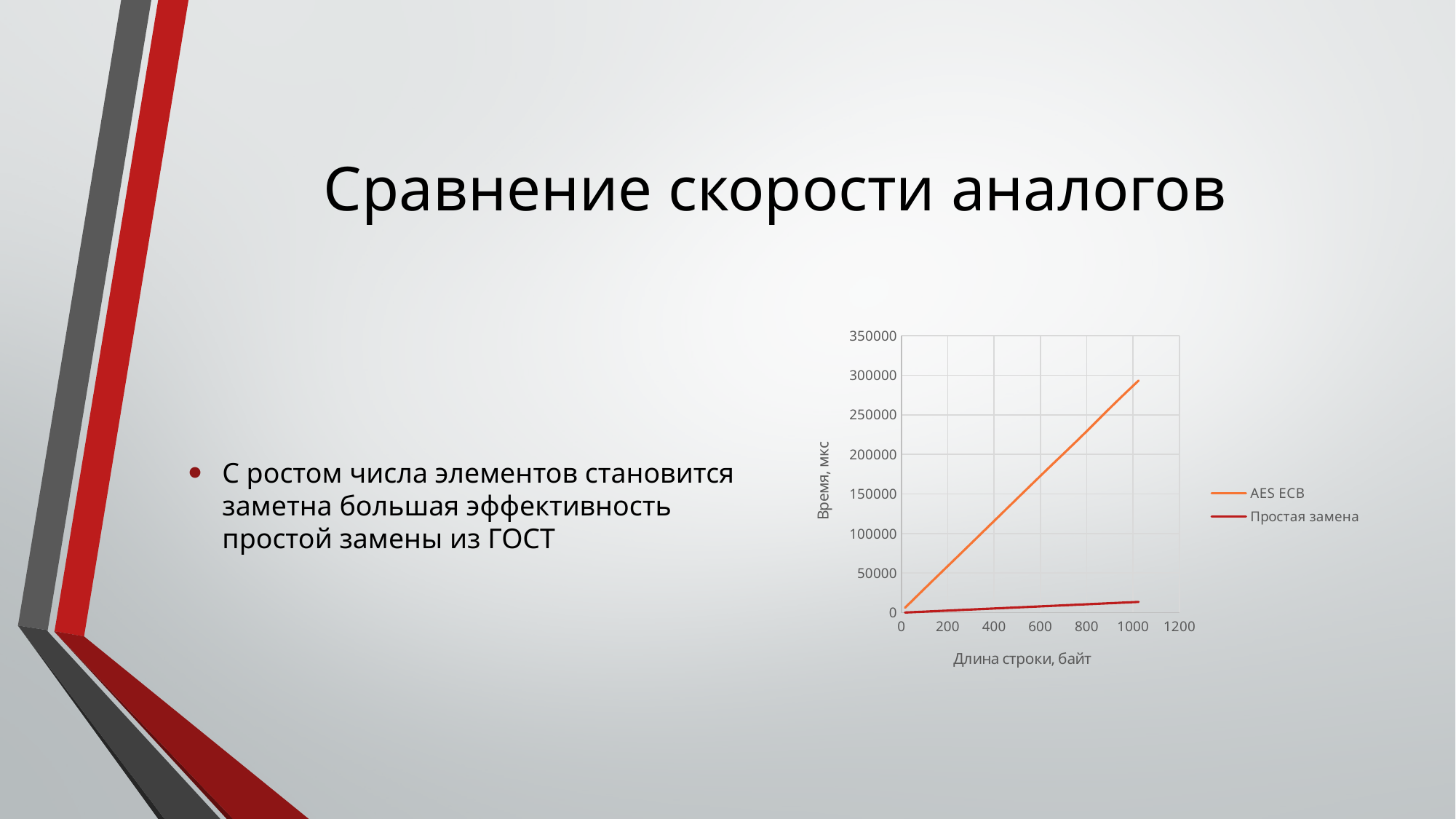
What is the title of the vertical axis of the chart? Время, мкс Is the value for AES ECB at a string length of 1000 bytes greater or less than 250000? greater Which series reaches the higher value at a string length of 1000 bytes, AES ECB or Простая замена? AES ECB Is the value for Простая замена at a string length of 1000 bytes greater or less than 50000? less Which series does the legend list first? AES ECB Does the AES ECB line rise or fall as the string length increases along the x axis? rise How many series does the chart legend list? 2 Is the value for AES ECB at a string length of 600 bytes greater or less than 100000? greater Which series has the lower values across the whole chart? Простая замена What kind of chart is shown on the slide? line chart Does the Простая замена line rise or fall along the x axis? rise